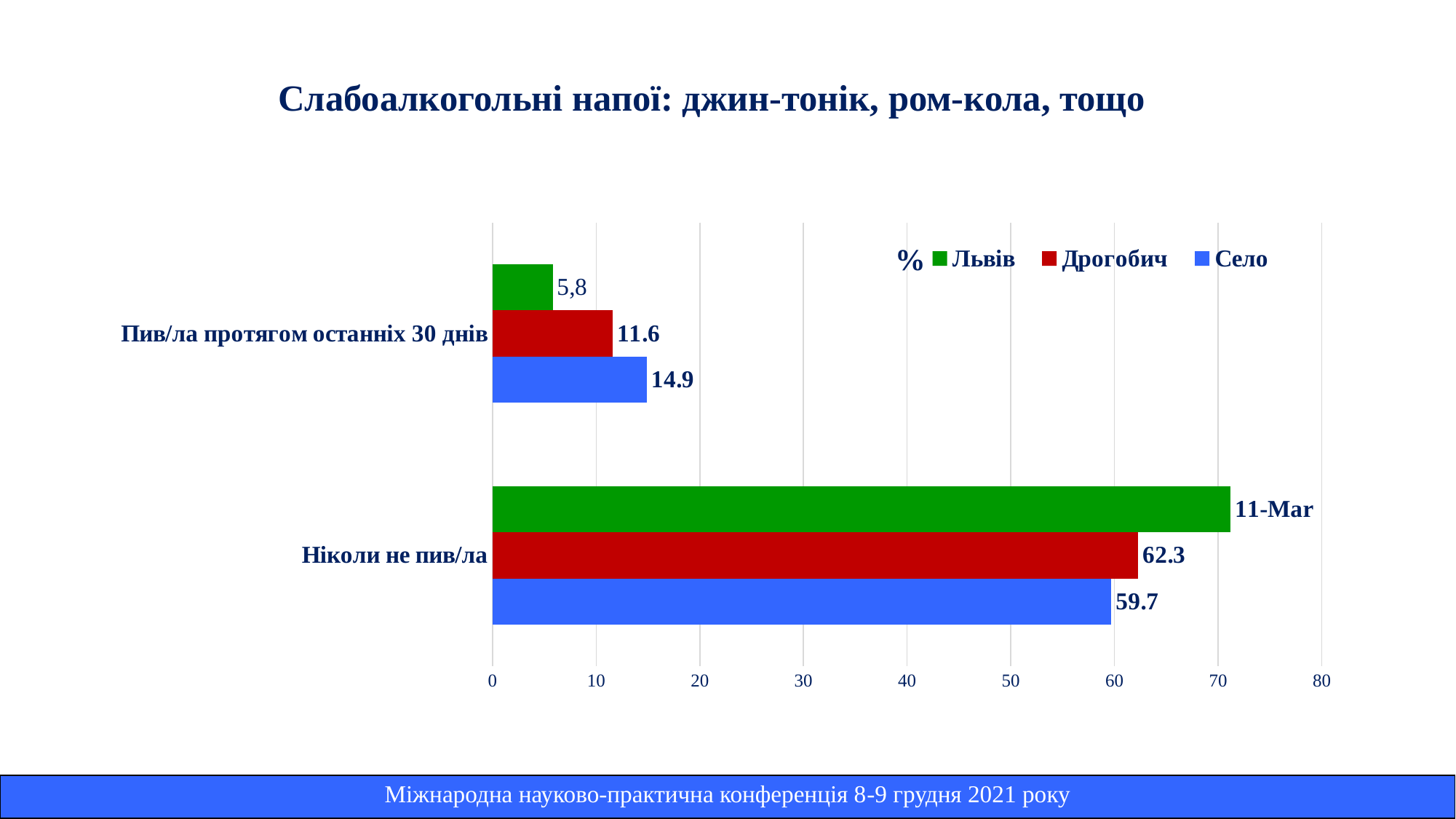
Is the value for Львів in the category "Ніколи не пив/ла" greater or less than 60? greater What is the value for Львів in the category "Пив/ла протягом останніх 30 днів"? 5,8 What is the value for Село in the category "Ніколи не пив/ла"? 59.7 What is the difference between the Село and Дрогобич values in the category "Пив/ла протягом останніх 30 днів"? 3.3 What is the value for Село in the category "Пив/ла протягом останніх 30 днів"? 14.9 How many series does the legend list? 3 Which series has the highest value in the category "Ніколи не пив/ла"? Львів How many categories are shown on the chart? 2 What is the value for Дрогобич in the category "Ніколи не пив/ла"? 62.3 What kind of chart is shown on the slide? bar chart What is the value for Дрогобич in the category "Пив/ла протягом останніх 30 днів"? 11.6 Which series has the lowest value in the category "Пив/ла протягом останніх 30 днів"? Львів